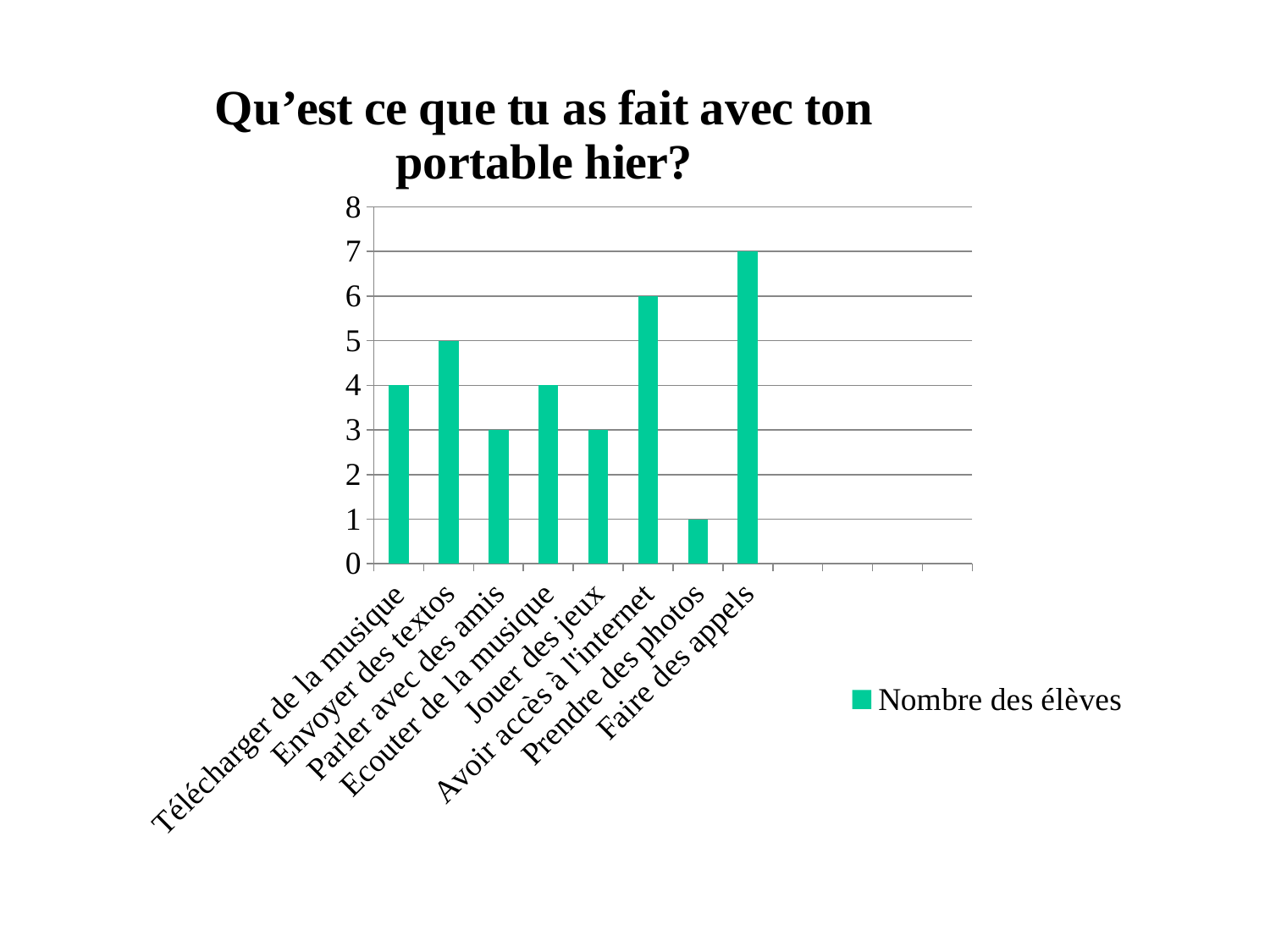
What is the value for Avoir accès à l'internet? 6 What is the value for Envoyer des textos? 5 What is the value for Faire des appels? 7 How many categories are shown on the x axis? 8 What is the difference between the values for Faire des appels and Prendre des photos? 6 Is the value for Avoir accès à l'internet greater or less than 4? greater Which category has the highest value? Faire des appels Which category has the lowest value? Prendre des photos What is the value for Prendre des photos? 1 Which is larger, the value for Envoyer des textos or the value for Parler avec des amis? Envoyer des textos What kind of chart is shown on the slide? bar chart What is the legend entry for the series shown? Nombre des élèves